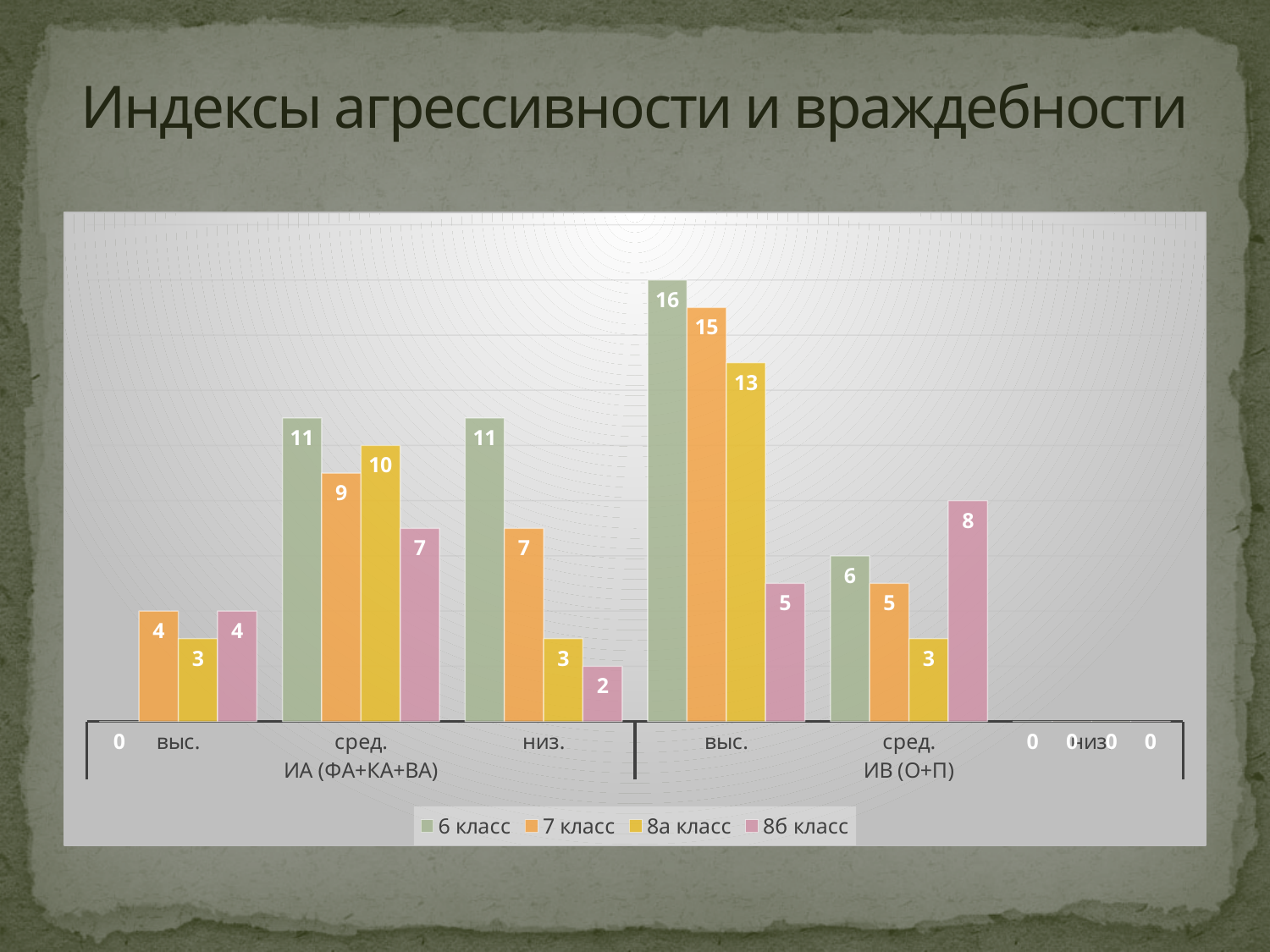
Which series has the lowest value in the низ. category of ИА (ФА+КА+ВА)? 8б класс What type of chart is shown on the slide? bar chart How many series does the legend list? 4 What is the value for 8б класс in the сред. category of ИВ (О+П)? 8 What is the value for 8а класс in the низ. category of ИА (ФА+КА+ВА)? 3 What is the difference between 6 класс and 8б класс in the выс. category of ИВ (О+П)? 11 What is the value for 6 класс in the выс. category of ИВ (О+П)? 16 What is the title of the chart? Индексы агрессивности и враждебности What is the value for 7 класс in the низ. category of ИВ (О+П)? 0 Which series has the highest value in the выс. category of ИВ (О+П)? 6 класс What is the value for 7 класс in the сред. category of ИА (ФА+КА+ВА)? 9 Which is larger in the сред. category of ИА (ФА+КА+ВА): 8а класс or 8б класс? 8а класс